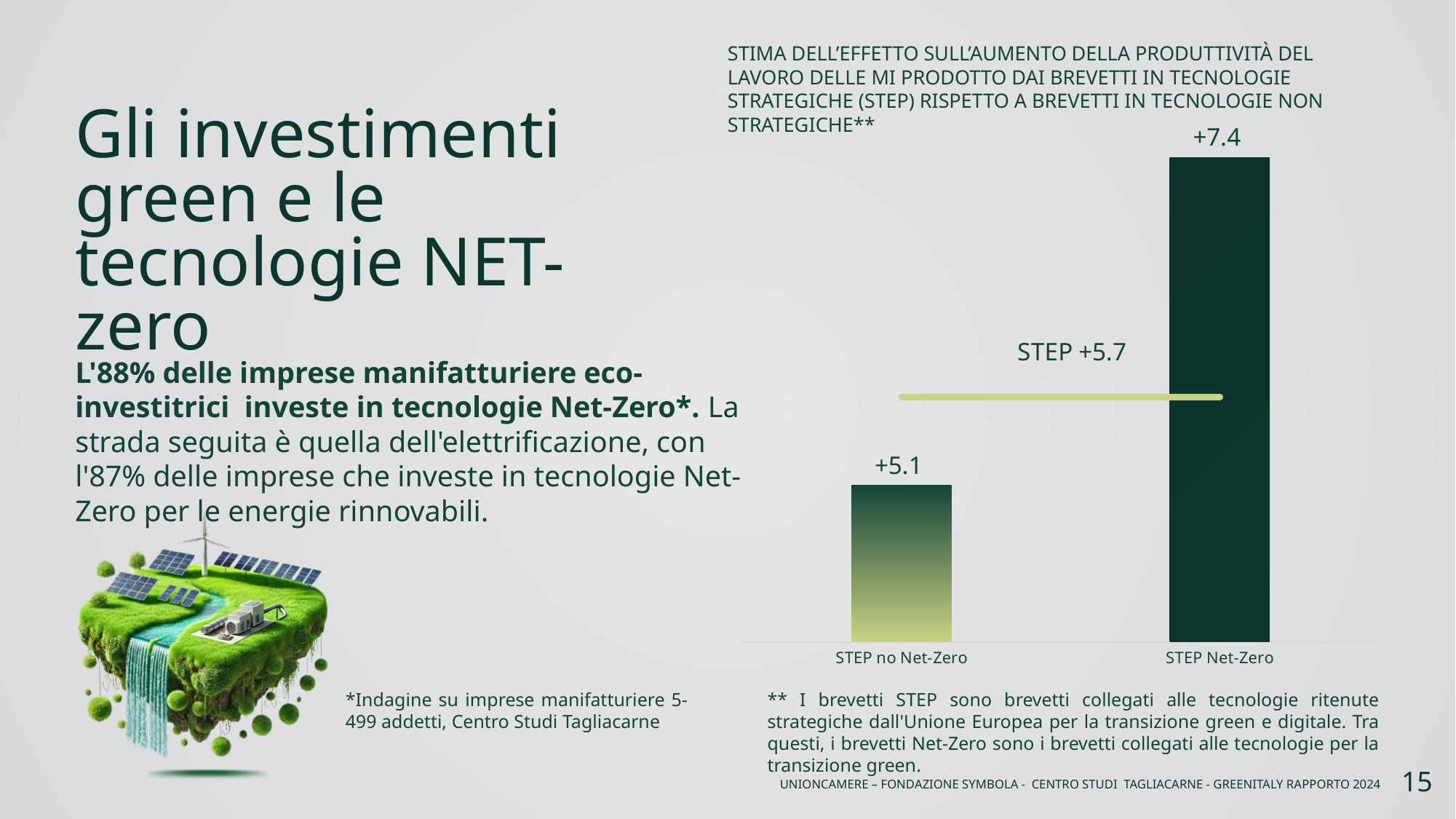
What value is shown for the STEP reference line? +5.7 What kind of chart is shown on the slide? Bar chart What is the label of the category on the left of the chart? STEP no Net-Zero How many bars are plotted in the chart? 2 Is the value for STEP no Net-Zero greater or less than the STEP reference line value of +5.7? less What is the value for STEP Net-Zero? +7.4 What is the difference between the STEP Net-Zero value and the STEP reference line value? 1.7 What is the difference between the values for STEP Net-Zero and STEP no Net-Zero? 2.3 What is the value for STEP no Net-Zero? +5.1 Which category has the lowest value? STEP no Net-Zero Which is larger, the value for STEP Net-Zero or the value for STEP no Net-Zero? STEP Net-Zero Which category has the highest value? STEP Net-Zero